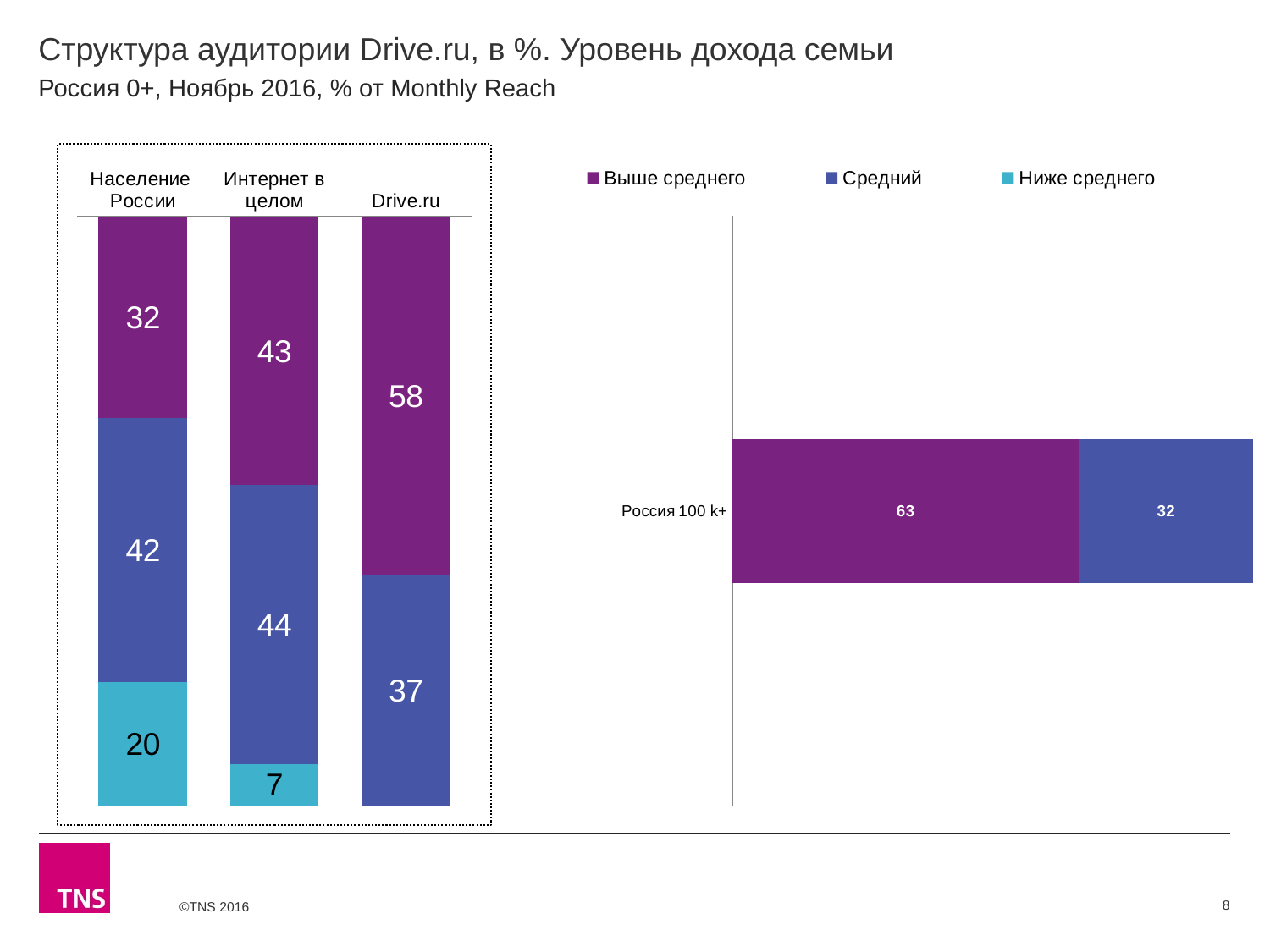
On the left chart, which category has the highest Выше среднего value? Drive.ru What kind of chart is the right chart (Россия 100 k+)? Stacked bar chart On the left chart, which is larger: the Средний value for Население России or for Drive.ru? Население России On the right chart, what is the total of the two labelled segments for Россия 100 k+? 95 On the left chart, what is the difference between the Выше среднего values for Drive.ru and Население России? 26 On the right chart, what is the Выше среднего value for Россия 100 k+? 63 On the left chart, what is the value of the Выше среднего segment for Drive.ru? 58 On the left chart, what is the value of the Средний segment for Интернет в целом? 44 How many series does the legend list? 3 How many categories are shown on the left chart? 3 On the left chart, which category has the lowest Ниже среднего value? Интернет в целом On the left chart, what is the value of the Ниже среднего segment for Население России? 20